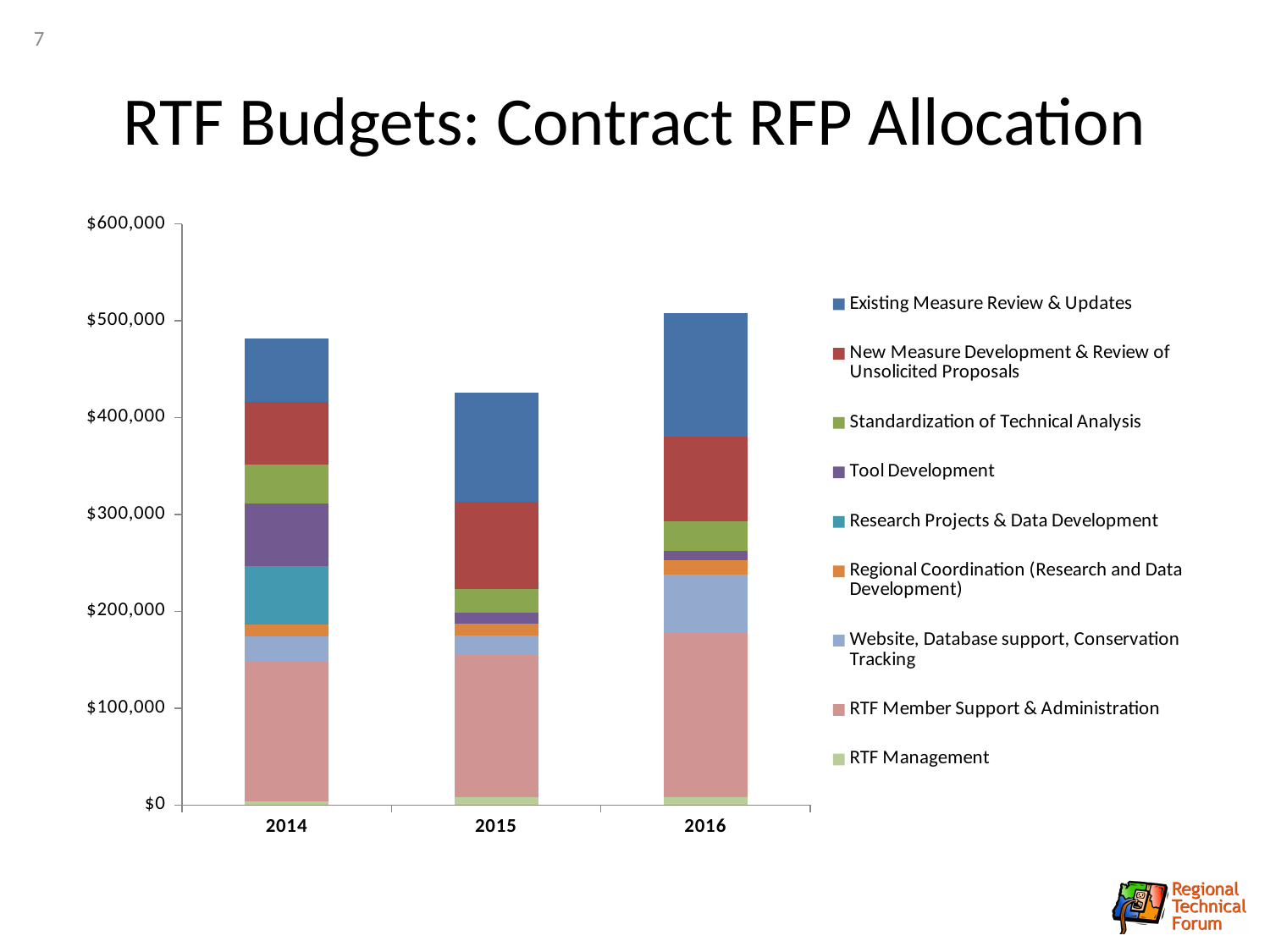
Which year has the lowest total budget bar? 2015 Does the total budget rise or fall from 2014 to 2015? fall What is the title of the chart on the slide? RTF Budgets: Contract RFP Allocation What type of chart is shown on the slide? Stacked bar chart Which series appears at the bottom of each stacked bar? RTF Management Which year has the highest total budget bar? 2016 How many series does the legend list? 9 Which year has the larger total bar, 2014 or 2015? 2014 Is the total bar for 2015 greater or less than $500,000? less Is the total bar for 2014 greater or less than $400,000? greater How many years are shown on the x axis of the chart? 3 Is the total bar for 2016 greater or less than $400,000? greater